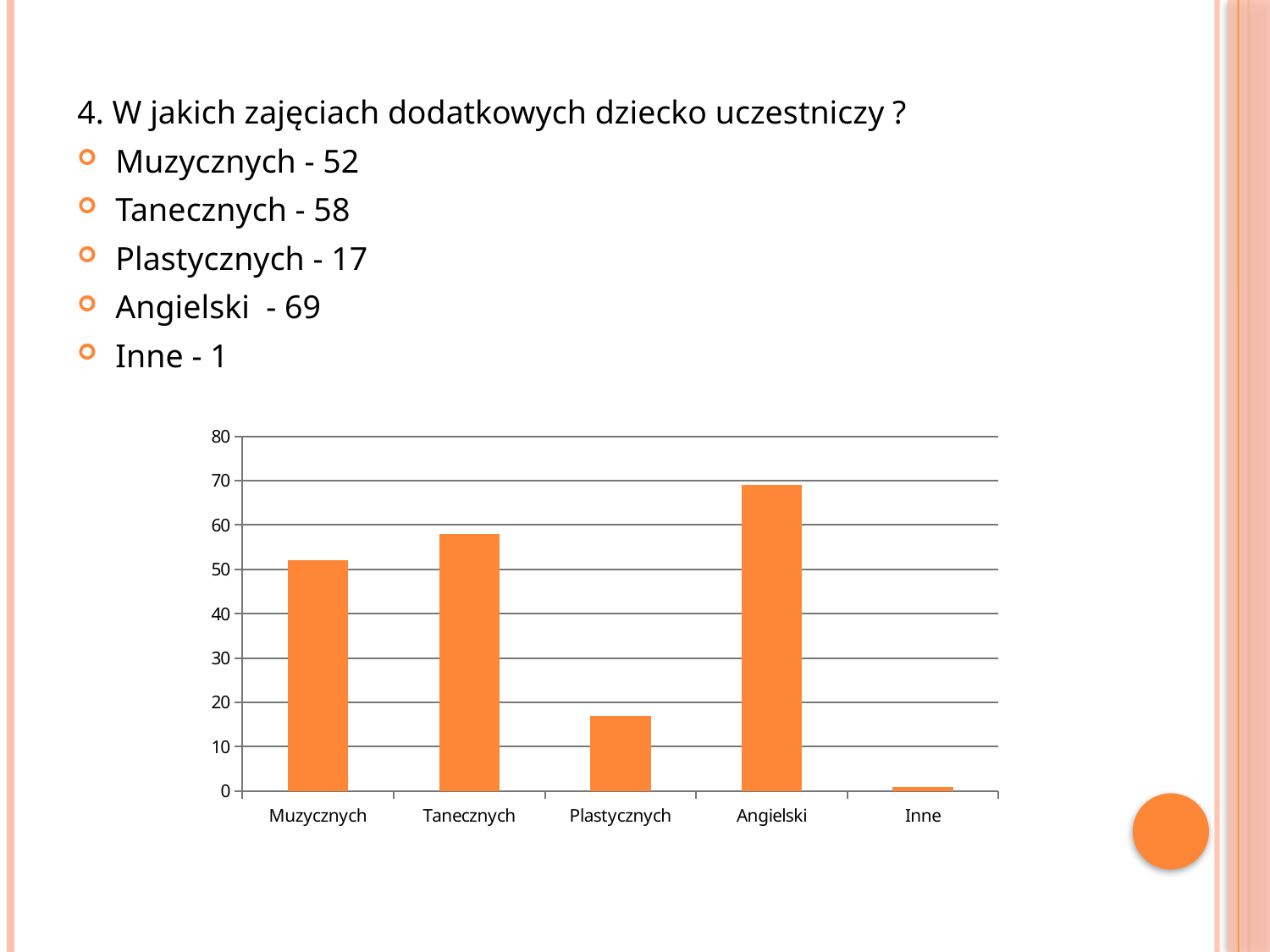
What is the value for Angielski? 69 Which is larger, the value for Muzycznych or the value for Tanecznych? Tanecznych How many categories are shown on the x axis of the chart? 5 Is the value for Muzycznych greater or less than 50? greater Which category has the highest bar in the chart? Angielski Is the value for Plastycznych greater or less than 20? less What is the value for Plastycznych? 17 What is the value for Tanecznych? 58 What type of chart is shown on the slide? bar chart Which category has the lowest bar in the chart? Inne What is the maximum value shown on the y axis of the chart? 80 What is the difference between the values for Angielski and Muzycznych? 17